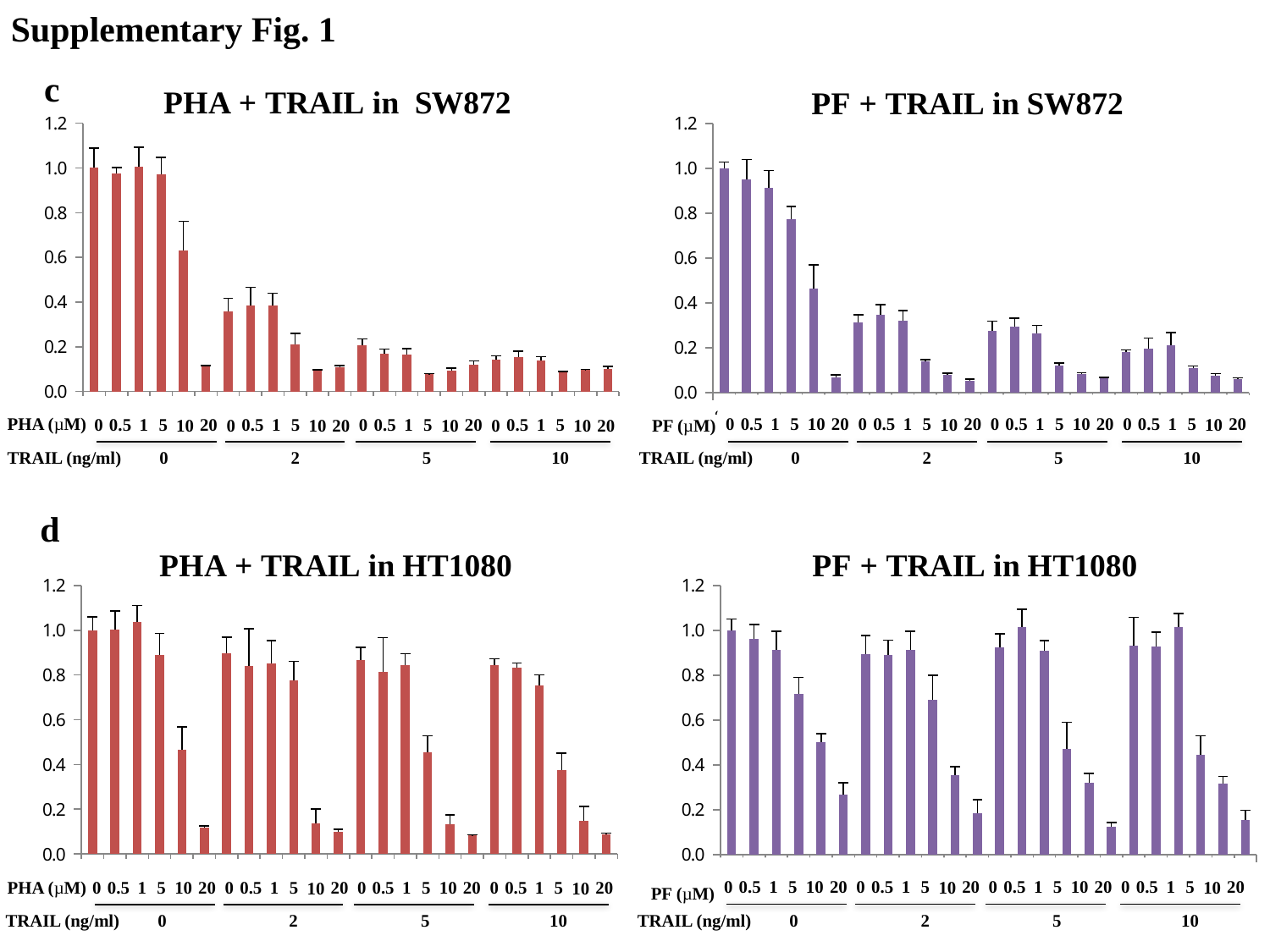
In the 'PF + TRAIL in SW872' chart, is the value for PF 20 µM at TRAIL 2 ng/ml greater or less than 0.2? less What is the highest tick value shown on the y axis of the 'PF + TRAIL in SW872' chart? 1.2 How many bars are plotted in the 'PF + TRAIL in HT1080' chart? 24 In the 'PHA + TRAIL in HT1080' chart, how many TRAIL (ng/ml) concentration groups are shown on the x axis? 4 What kind of chart is 'PHA + TRAIL in SW872'? bar chart In the 'PF + TRAIL in HT1080' chart, within the TRAIL 0 ng/ml group, which PF concentration has the lowest bar? 20 µM In the 'PF + TRAIL in SW872' chart, is the value for PF 5 µM at TRAIL 0 ng/ml greater or less than 0.6? greater In the 'PHA + TRAIL in SW872' chart, is the value for PHA 20 µM at TRAIL 0 ng/ml greater or less than 0.2? less In the 'PHA + TRAIL in HT1080' chart, within the TRAIL 10 ng/ml group, do the bars rise or fall as the PHA concentration increases from 1 to 20 µM? fall In the 'PF + TRAIL in HT1080' chart, within the TRAIL 5 ng/ml group, which is larger: the bar for PF 0.5 µM or the bar for PF 20 µM? PF 0.5 µM In the 'PHA + TRAIL in HT1080' chart, within the TRAIL 0 ng/ml group, which is larger: the bar for PHA 1 µM or the bar for PHA 20 µM? PHA 1 µM